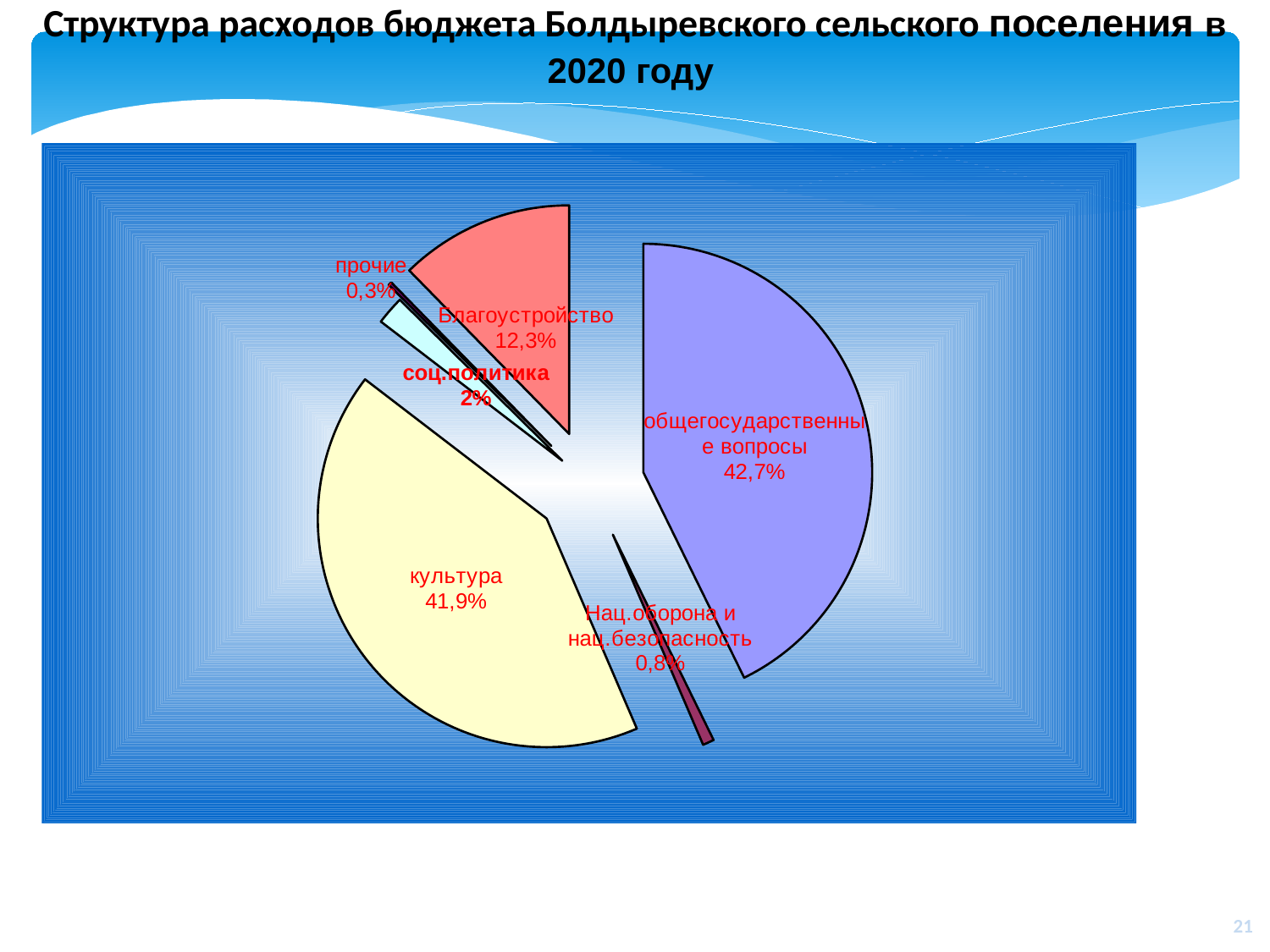
How many slices does the pie chart have? 6 What share of the budget expenditure goes to культура? 41,9% What share is shown for общегосударственные вопросы? 42,7% Which category has the largest share of the pie? общегосударственные вопросы What year does the chart title refer to? 2020 Which category has the smallest share of the pie? прочие What percentage is labelled for Благоустройство? 12,3% What percentage is shown for Нац.оборона и нац.безопасность? 0,8% What is the difference in percentage points between общегосударственные вопросы and культура? 0,8 Which is larger: the share for Благоустройство or the share for соц.политика? Благоустройство What share is shown for соц.политика? 2% What kind of chart is shown on the slide? pie chart